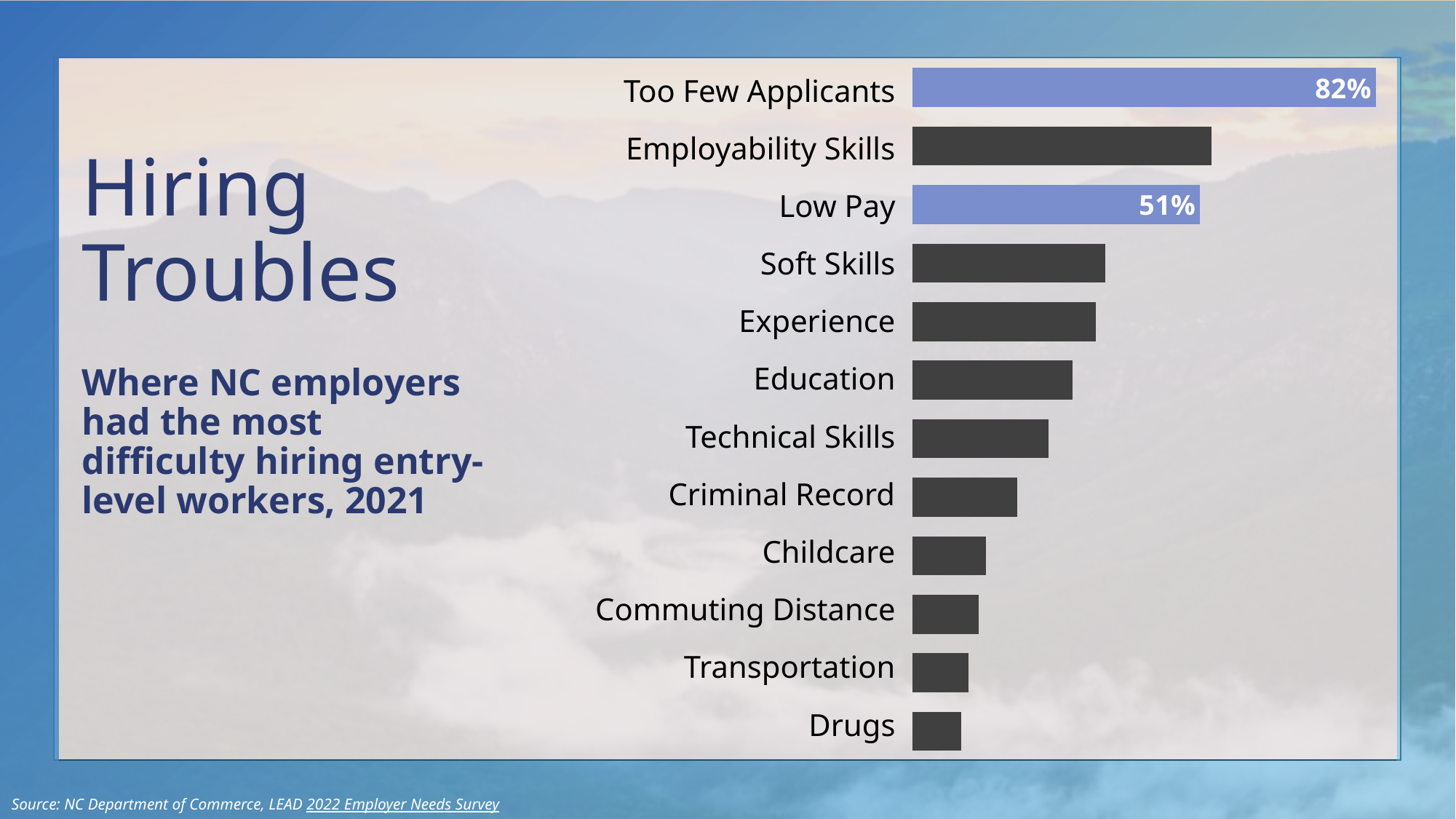
What is the title of the slide containing the chart? Hiring Troubles Which is larger, the value for Transportation or the value for Drugs? Transportation Which is larger, the value for Employability Skills or the value for Soft Skills? Employability Skills What kind of chart is shown on the slide? Bar chart Which is larger, the value for Childcare or the value for Criminal Record? Criminal Record Which category has the highest value in the chart? Too Few Applicants Which category has the lowest value in the chart? Drugs What percentage of NC employers reported Too Few Applicants as a hiring difficulty? 82% How many categories are shown in the chart? 12 What percentage is shown for Low Pay? 51% What is the difference in percentage points between Too Few Applicants and Low Pay? 31 percentage points Which two bars are highlighted in blue rather than dark grey? Too Few Applicants and Low Pay